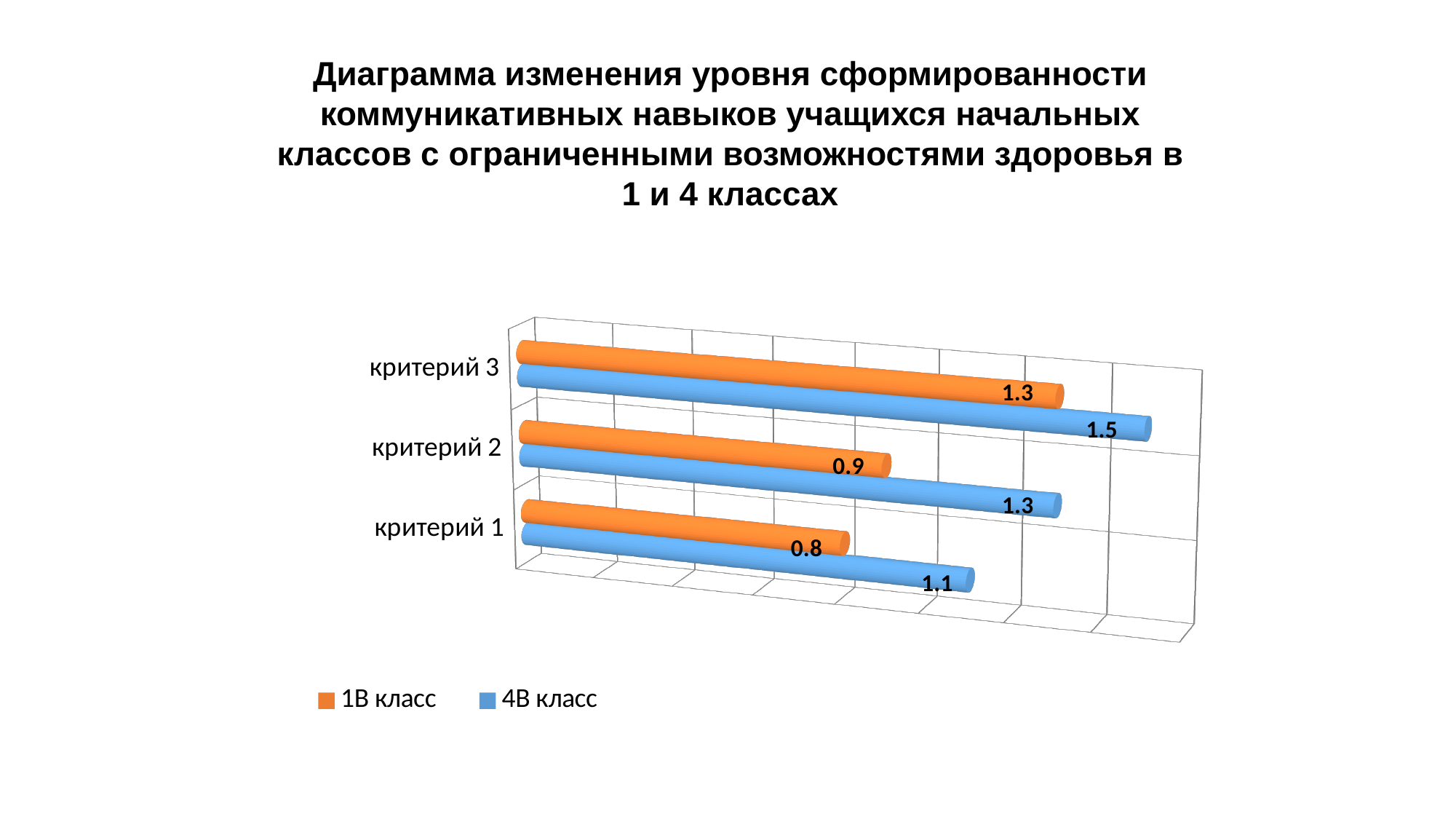
What is the difference between 4В класс and 1В класс on критерий 2? 0.4 What is the value for 1В класс on критерий 1? 0.8 What kind of chart is shown on the slide? bar chart Which criterion has the lowest value for 1В класс? критерий 1 Which colour represents 4В класс in the chart? blue What is the value for 4В класс on критерий 2? 1.3 What is the value for 4В класс on критерий 3? 1.5 How many criteria are shown on the chart? 3 What is the value for 1В класс on критерий 2? 0.9 How many series does the legend list? 2 Which criterion has the highest value for 4В класс? критерий 3 Which is larger on критерий 1: 1В класс or 4В класс? 4В класс